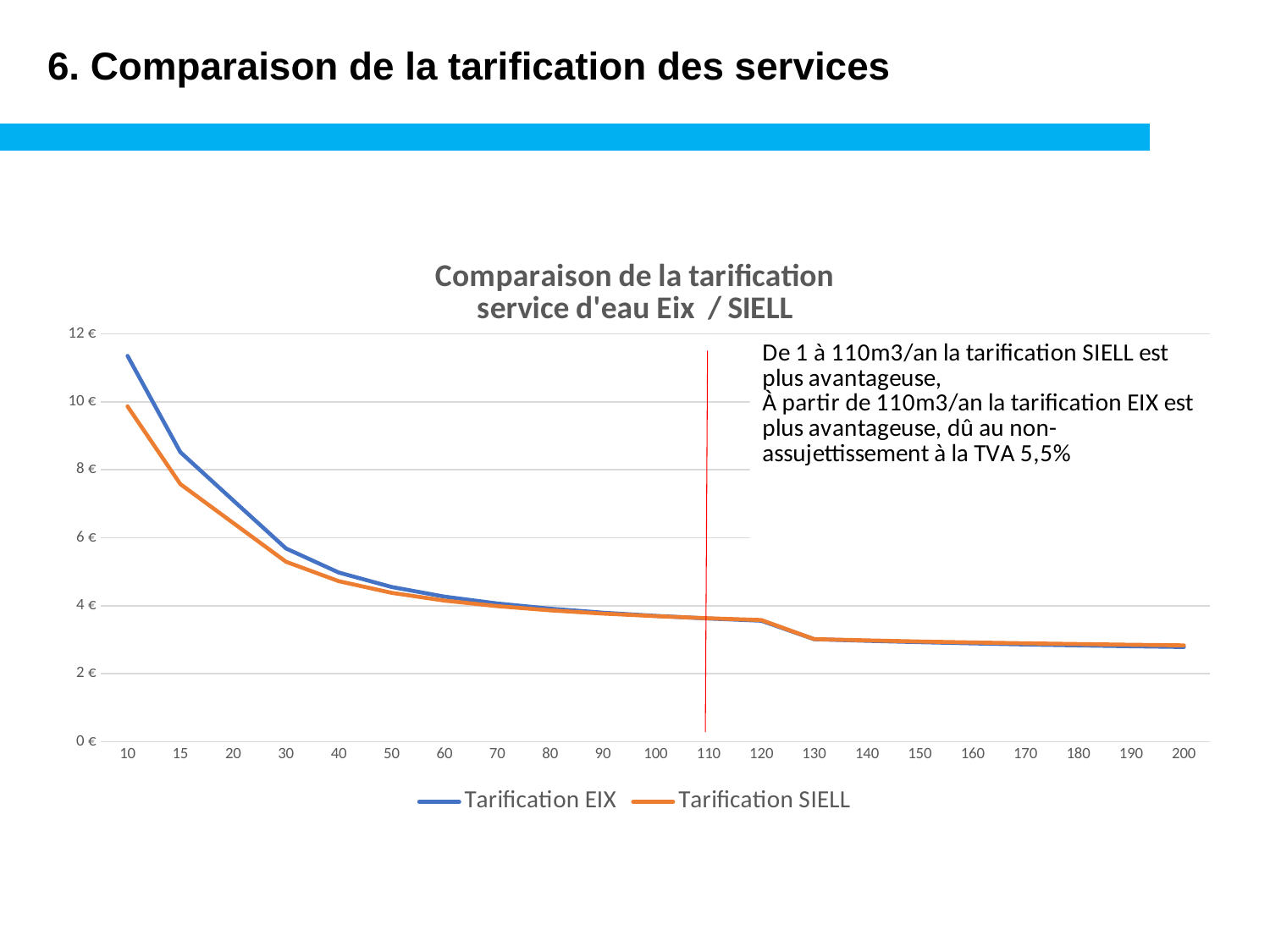
At x = 10, which series has the larger value, Tarification EIX or Tarification SIELL? Tarification EIX Do the values of Tarification SIELL rise or fall along the x axis? fall Is the value of Tarification EIX at x = 10 greater or less than 10 €? greater At which x value is Tarification EIX highest? 10 How many points are plotted along the x axis for each series? 21 How many series does the legend list? 2 What kind of chart is shown on the slide? line chart Is the value of Tarification EIX at x = 100 greater or less than 4 €? less At x = 20, which series has the larger value, Tarification EIX or Tarification SIELL? Tarification EIX Do the values of Tarification EIX rise or fall as the x axis increases from 10 to 200? fall What are the two series named in the legend? Tarification EIX and Tarification SIELL Is the value of Tarification SIELL at x = 15 greater or less than 8 €? less